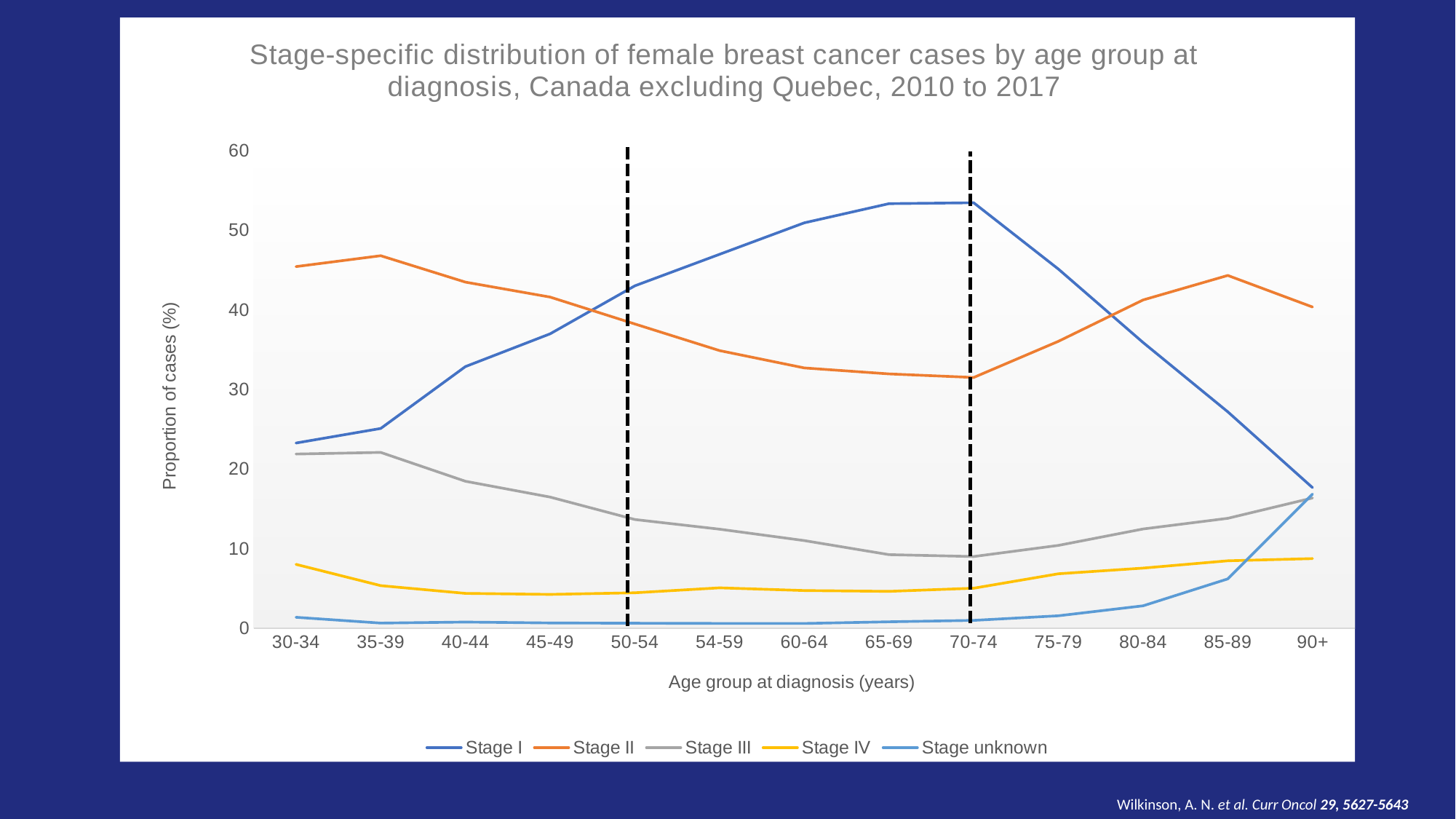
Which age group has the lowest Stage I proportion? 90+ How many series does the legend list? 5 What kind of chart is shown on the slide? line chart Does the Stage III line rise or fall from 30-34 to 70-74? fall Is the Stage I value for the 30-34 age group greater or less than 30? less How many age groups are shown on the x axis? 13 What is the title of the x axis? Age group at diagnosis (years) At the 60-64 age group, which is larger, Stage I or Stage II? Stage I Is the Stage I value for the 50-54 age group greater or less than 40? greater Which age group has the highest Stage II proportion? 35-39 Which series has the highest value at the 90+ age group? Stage II At the 30-34 age group, which is larger, Stage I or Stage II? Stage II